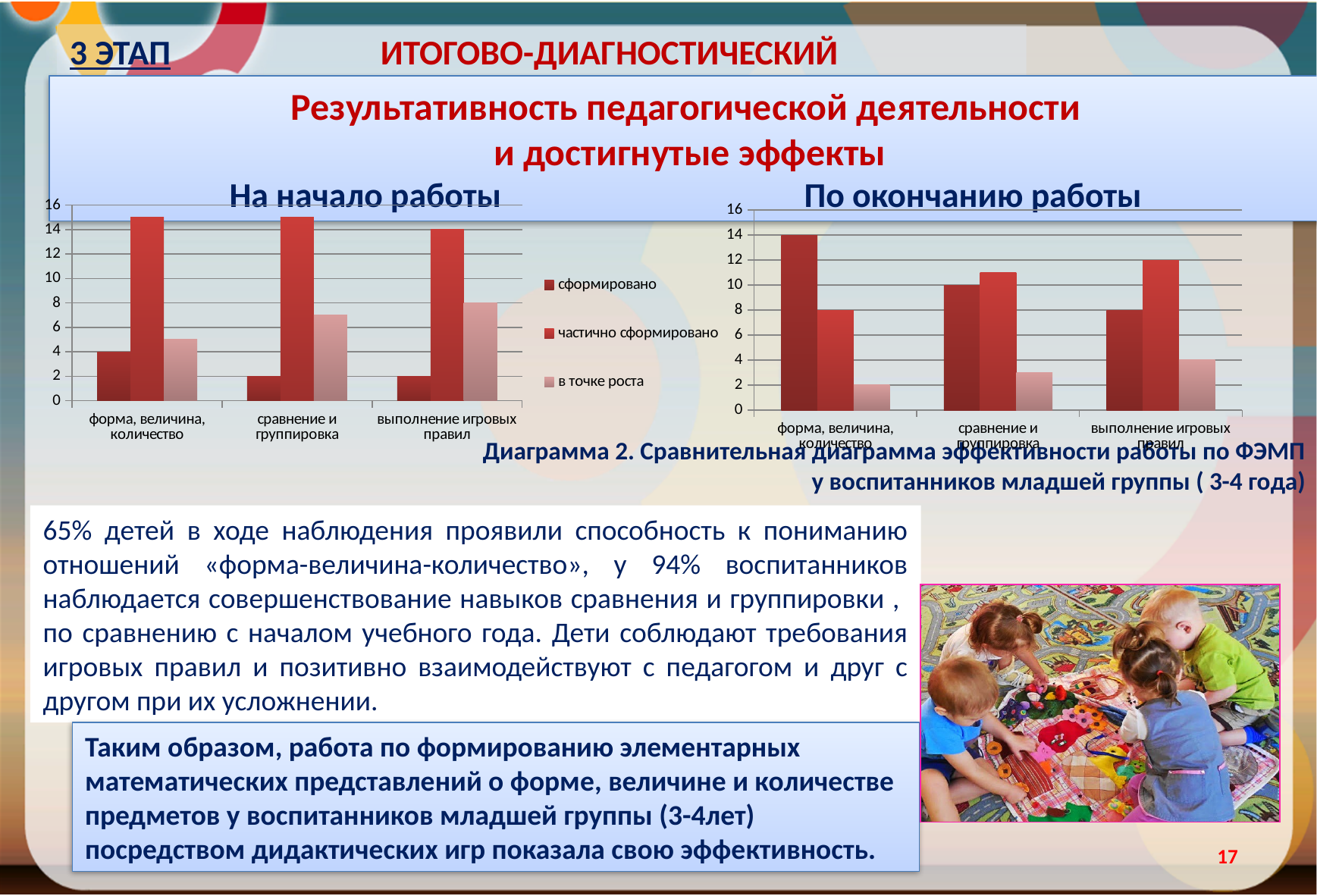
In the 'На начало работы' chart, what is the value of 'в точке роста' for 'выполнение игровых правил'? 8 In the 'По окончанию работы' chart, what is the difference between the 'сформировано' values for 'форма, величина, количество' and 'выполнение игровых правил'? 6 In the 'На начало работы' chart, what is the value of 'сформировано' for 'форма, величина, количество'? 4 In the 'По окончанию работы' chart, which category has the lowest 'сформировано' value? выполнение игровых правил How many series does the legend list? 3 In the 'По окончанию работы' chart, what is the value of 'частично сформировано' for 'выполнение игровых правил'? 12 How many categories are shown on the x axis of the 'По окончанию работы' chart? 3 What kind of chart is used for 'На начало работы'? bar chart In the 'На начало работы' chart, is the value of 'частично сформировано' for 'форма, величина, количество' greater or less than 14? greater In the 'По окончанию работы' chart, what is the value of 'сформировано' for 'форма, величина, количество'? 14 In the 'На начало работы' chart, for 'выполнение игровых правил', which is larger: 'сформировано' or 'в точке роста'? в точке роста In the 'По окончанию работы' chart, which category has the highest 'сформировано' value? форма, величина, количество